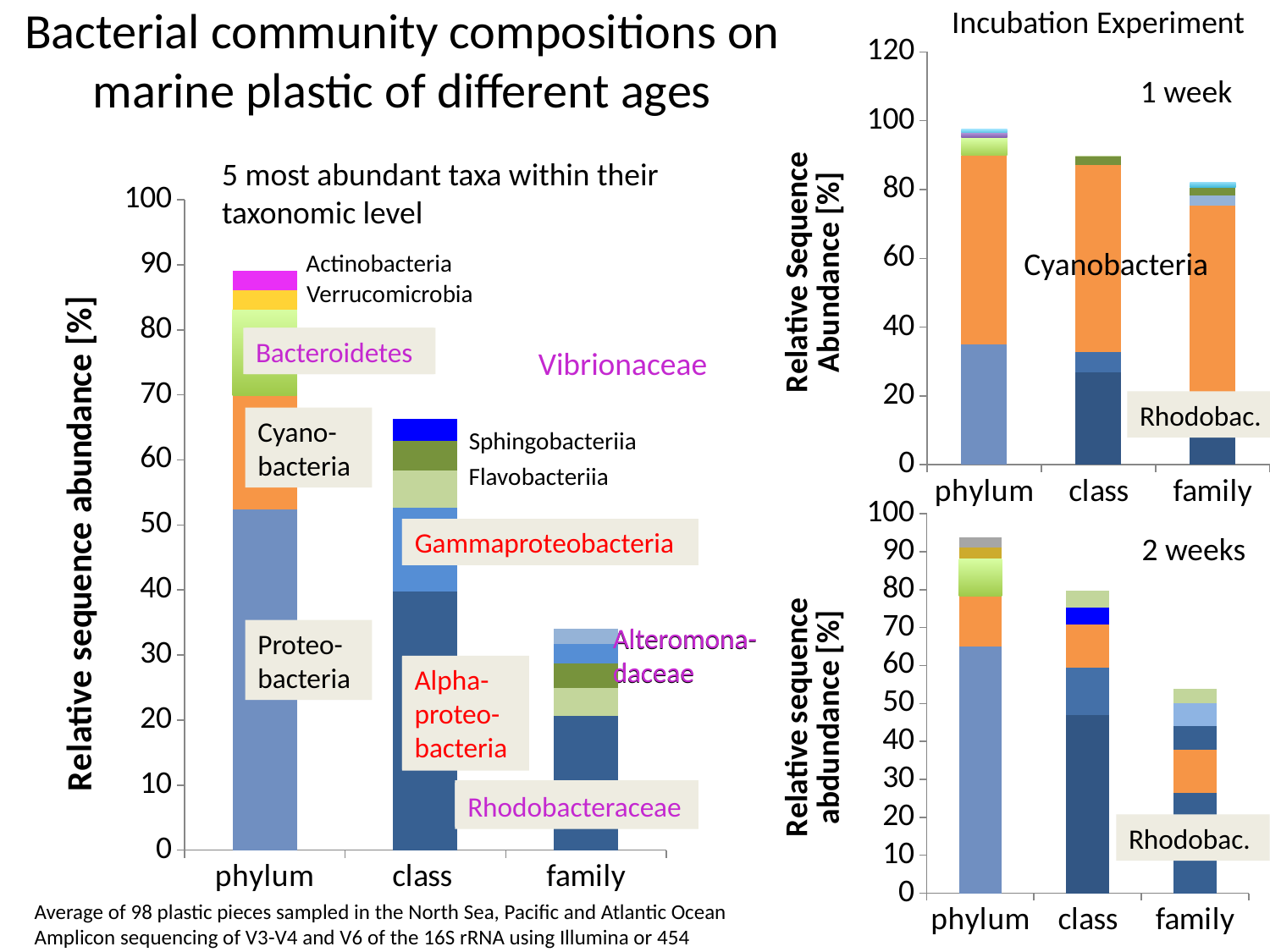
On the 1 week incubation chart, which category has the tallest stacked bar? phylum On the 2 weeks incubation chart, which category has the shortest stacked bar? family On the left chart, is the total height of the family bar greater or less than 40? less On the 2 weeks incubation chart, is the total height of the class bar greater or less than 90? less On the 1 week incubation chart, is the total height of the phylum bar greater or less than 90? greater On the left chart, which category has the shortest stacked bar? family On the left chart, which category has the tallest stacked bar? phylum On the left chart, how many categories are shown on the x axis? 3 What is the y-axis title of the left chart? Relative sequence abundance [%] What kind of chart is the left chart? stacked bar chart